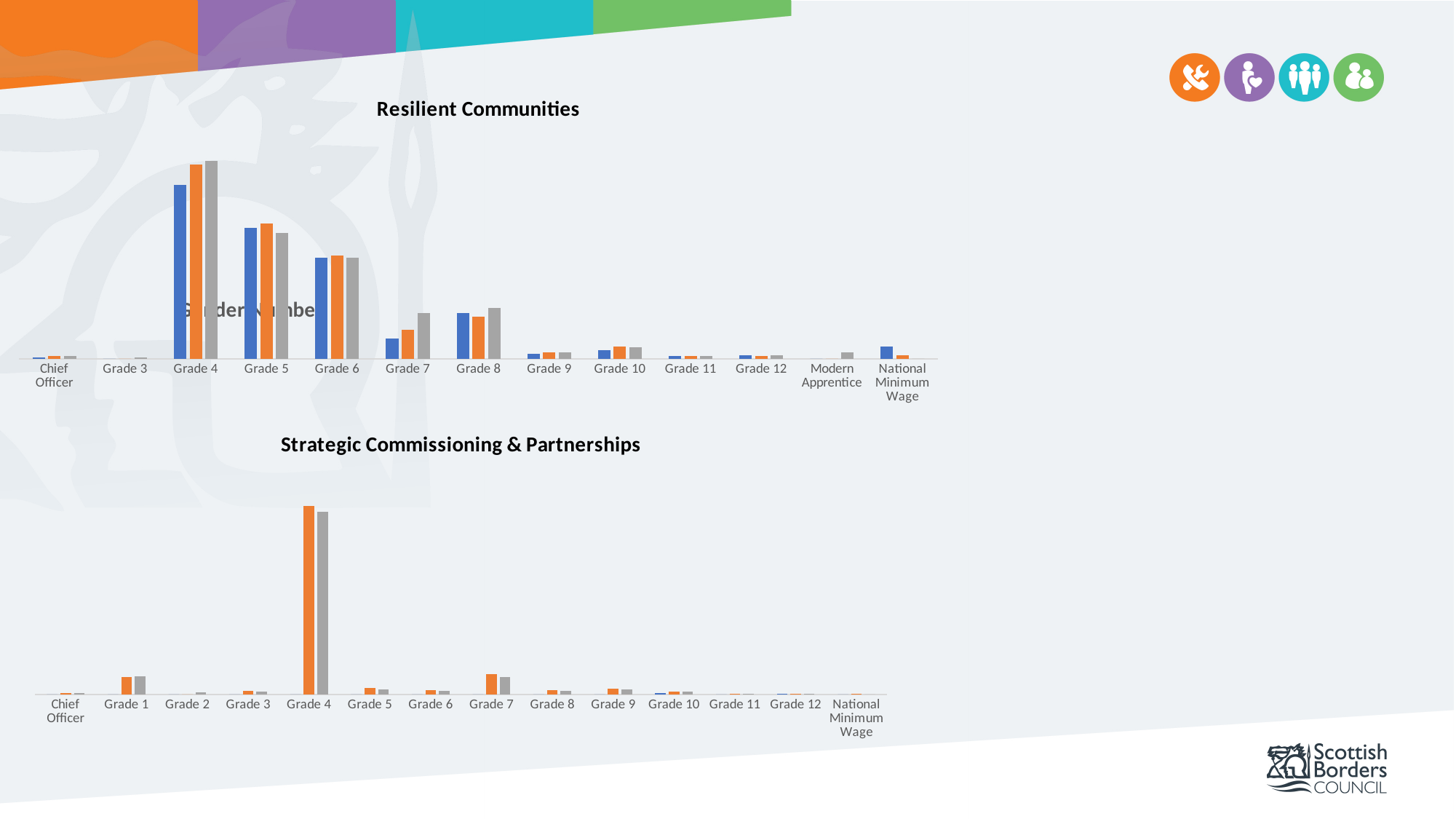
In the 'Resilient Communities' chart, which category has the tallest bars? Grade 4 In the 'Strategic Commissioning & Partnerships' chart, which category has the tallest bars? Grade 4 In the 'Resilient Communities' chart, how many categories are shown on the x axis? 13 What is the title of the bottom chart on the slide? Strategic Commissioning & Partnerships What kind of chart is the 'Strategic Commissioning & Partnerships' chart? Bar chart In the 'Strategic Commissioning & Partnerships' chart, how many categories are shown on the x axis? 14 In the 'Resilient Communities' chart, which has taller bars, Grade 4 or Grade 8? Grade 4 What is the title of the top chart on the slide? Resilient Communities In the 'Strategic Commissioning & Partnerships' chart, which has taller bars, Grade 4 or Grade 1? Grade 4 In the 'Resilient Communities' chart, which has taller bars, Grade 5 or Grade 6? Grade 5 What kind of chart is the 'Resilient Communities' chart? Bar chart